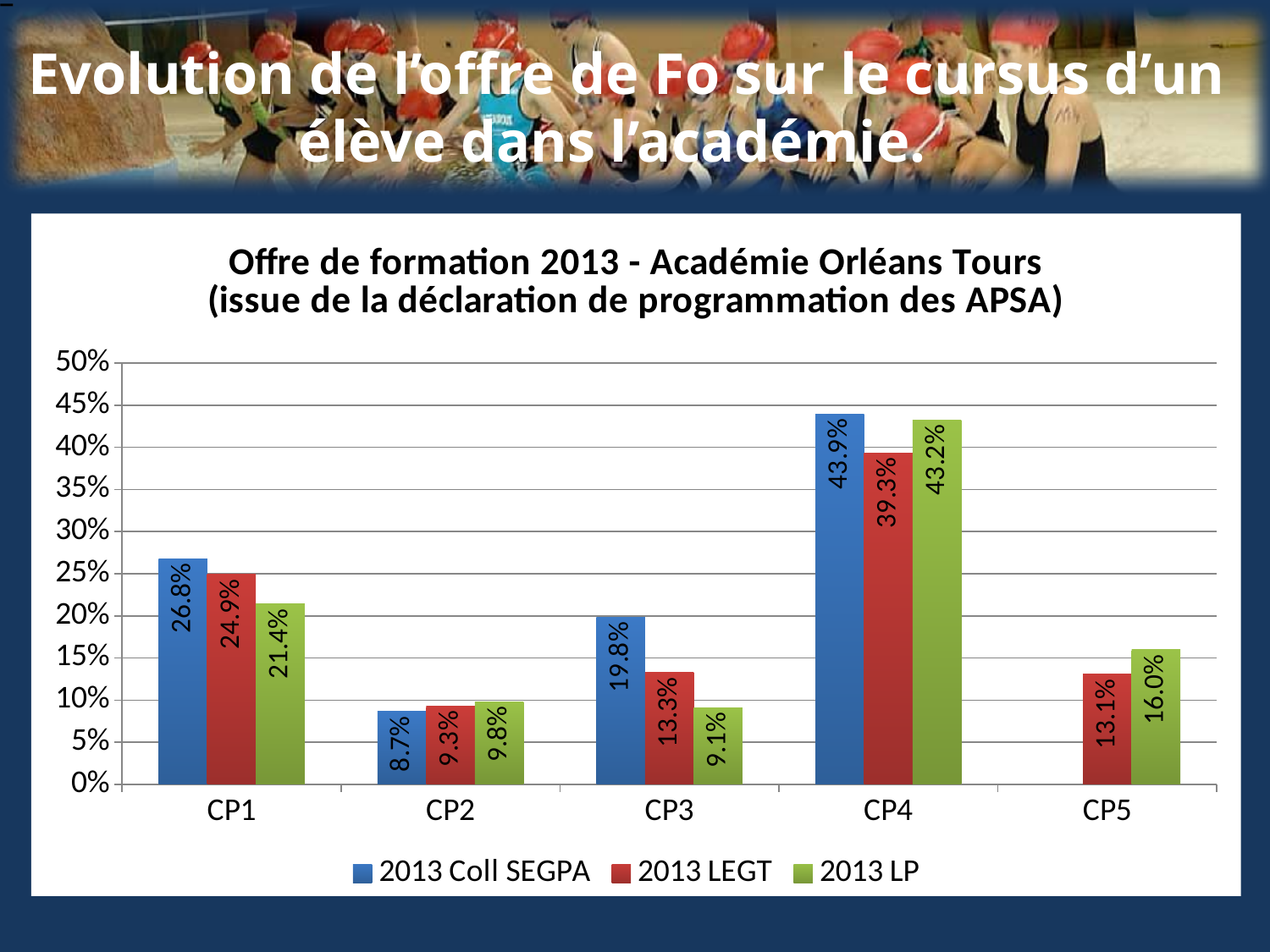
What kind of chart is shown on the slide? Bar chart How many series does the legend list? 3 Which category has the lowest value for the 2013 Coll SEGPA series? CP2 Which category has the highest value for the 2013 LEGT series? CP4 Is the value for 2013 LEGT at CP4 greater or less than 35%? greater What is the value for 2013 LP at CP5? 16.0% How many categories are shown on the x axis? 5 Which is larger at CP1: the 2013 Coll SEGPA value or the 2013 LP value? 2013 Coll SEGPA What is the difference between the 2013 Coll SEGPA and 2013 LEGT values at CP3? 6.5% What is the value for 2013 LEGT at CP1? 24.9% What is the value for 2013 Coll SEGPA at CP4? 43.9% What is the value for 2013 LP at CP2? 9.8%